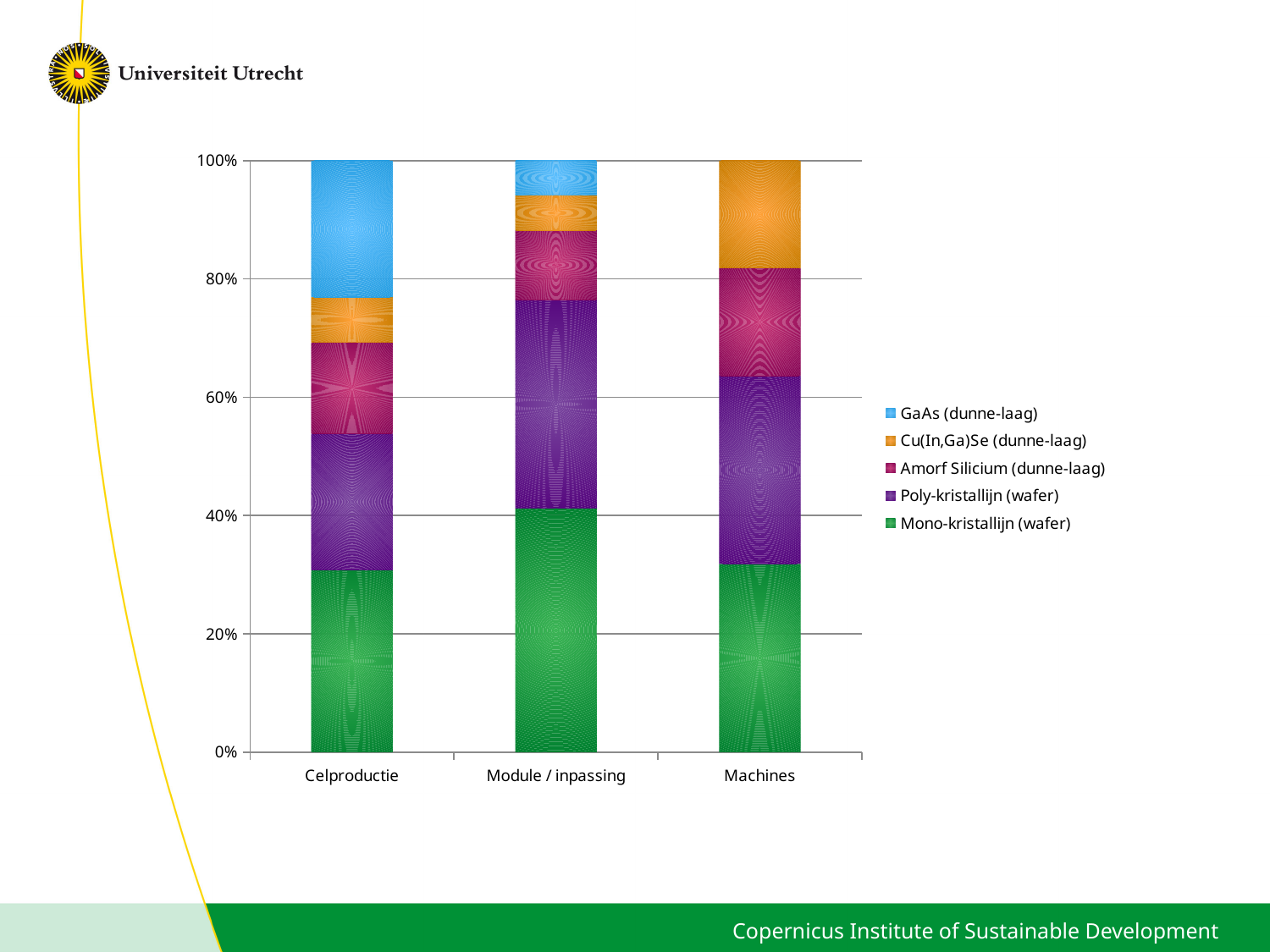
How many categories are shown on the x axis of the chart? 3 Which category has the largest GaAs (dunne-laag) share? Celproductie Which category has the largest Mono-kristallijn (wafer) share? Module / inpassing Which series is shown in blue in the chart? GaAs (dunne-laag) Is the Mono-kristallijn (wafer) share larger for Module / inpassing or for Celproductie? Module / inpassing Is the Mono-kristallijn (wafer) share for Module / inpassing greater or less than 20%? greater What is the total height of the stacked bar for Machines? 100% Which series is listed at the bottom of the legend? Mono-kristallijn (wafer) What kind of chart is shown on the slide? stacked bar chart How many series does the chart's legend list? 5 Which category has the largest Cu(In,Ga)Se (dunne-laag) share? Machines Is the Mono-kristallijn (wafer) share for Celproductie greater or less than 40%? less